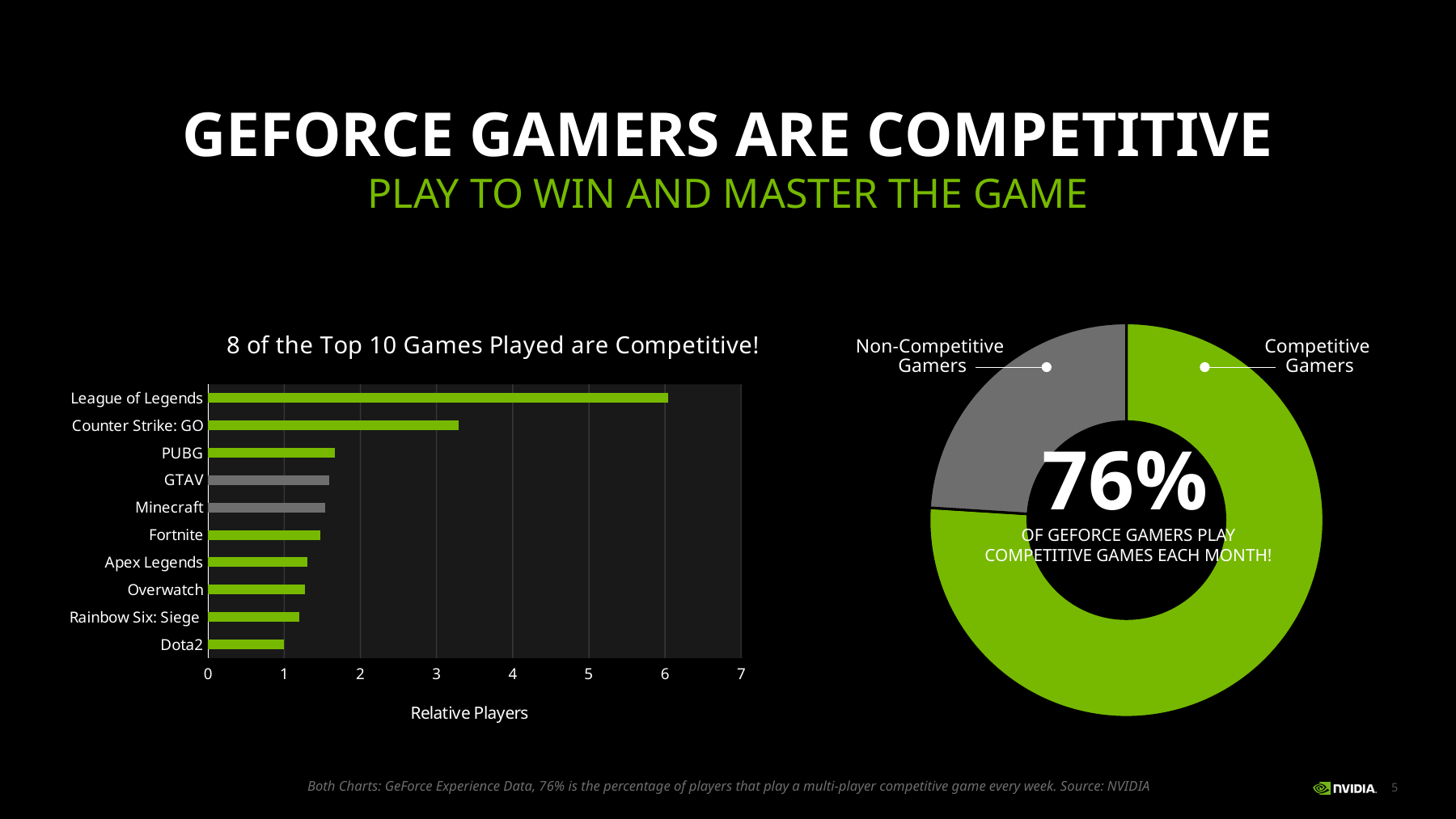
On the left bar chart, how many games are listed? 10 On the right chart, which segment is larger, Competitive Gamers or Non-Competitive Gamers? Competitive Gamers On the left bar chart, which game has the lowest number of relative players? Dota2 On the left bar chart, what is the label of the horizontal axis? Relative Players On the left chart titled '8 of the Top 10 Games Played are Competitive!', what kind of chart is it? bar chart On the left bar chart, which has more relative players, Counter Strike: GO or PUBG? Counter Strike: GO On the right chart, what share of GeForce gamers are Competitive Gamers? 76% On the left bar chart, is the value for Counter Strike: GO greater or less than 3? greater On the left bar chart, which game has the highest number of relative players? League of Legends On the right chart, how many segments does the chart have? 2 On the left bar chart, is the value for League of Legends greater or less than 5? greater On the left bar chart, is the value for PUBG greater or less than 2? less